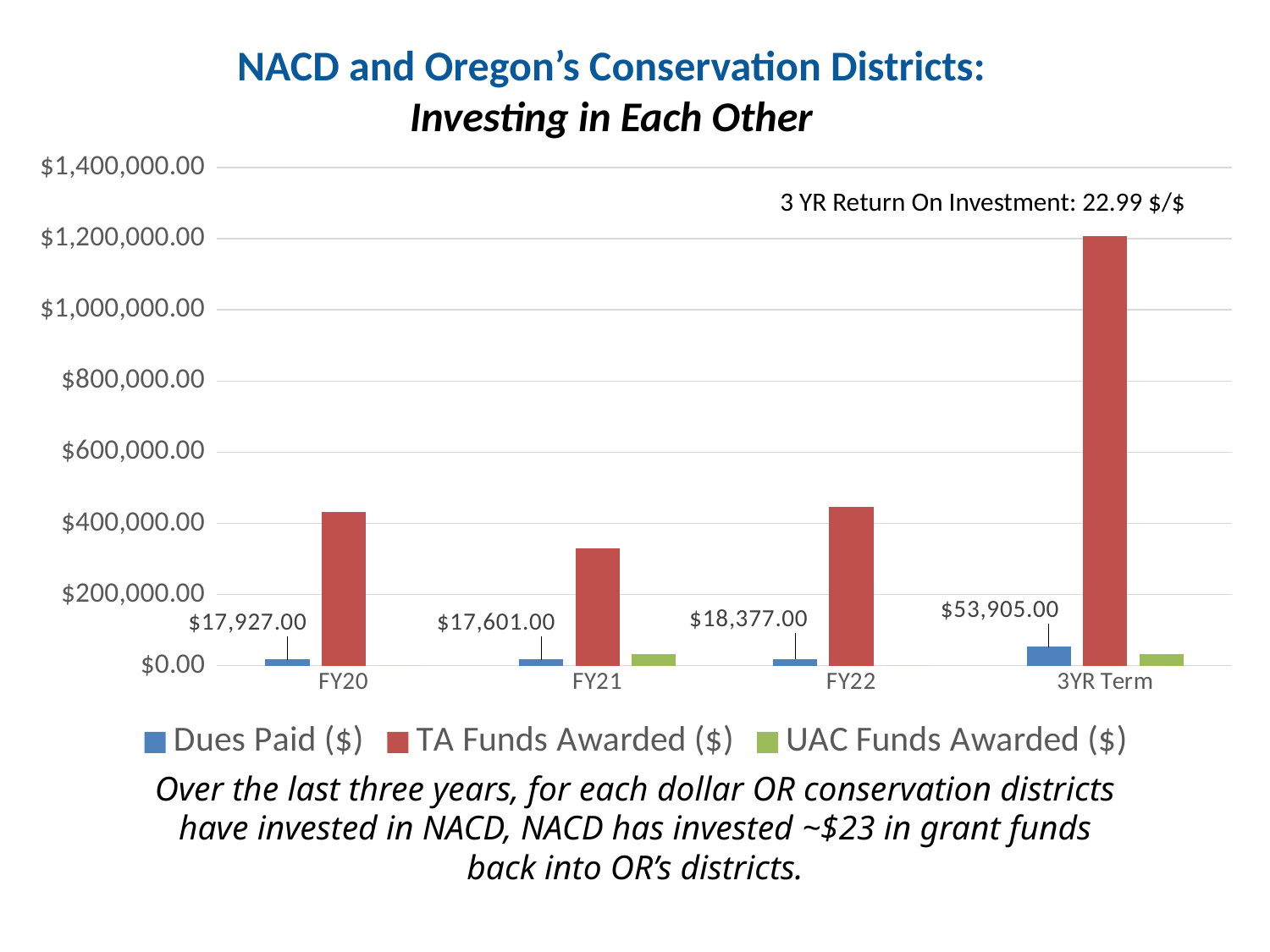
What is the 3 YR Return On Investment stated on the chart? 22.99 $/$ How many series does the legend list? 3 Which is larger, TA Funds Awarded ($) in FY22 or in FY21? FY22 Which category has the highest TA Funds Awarded ($)? 3YR Term What is the value of Dues Paid ($) for FY22? $18,377.00 Among FY20, FY21 and FY22, which fiscal year has the lowest Dues Paid ($)? FY21 Is the TA Funds Awarded ($) value for FY20 greater or less than $400,000.00? greater What is the value of Dues Paid ($) for FY20? $17,927.00 What is the value of Dues Paid ($) for the 3YR Term? $53,905.00 Is the TA Funds Awarded ($) value for FY21 greater or less than $400,000.00? less How many categories are shown on the x axis? 4 What is the difference between Dues Paid ($) in FY22 and FY21? $776.00